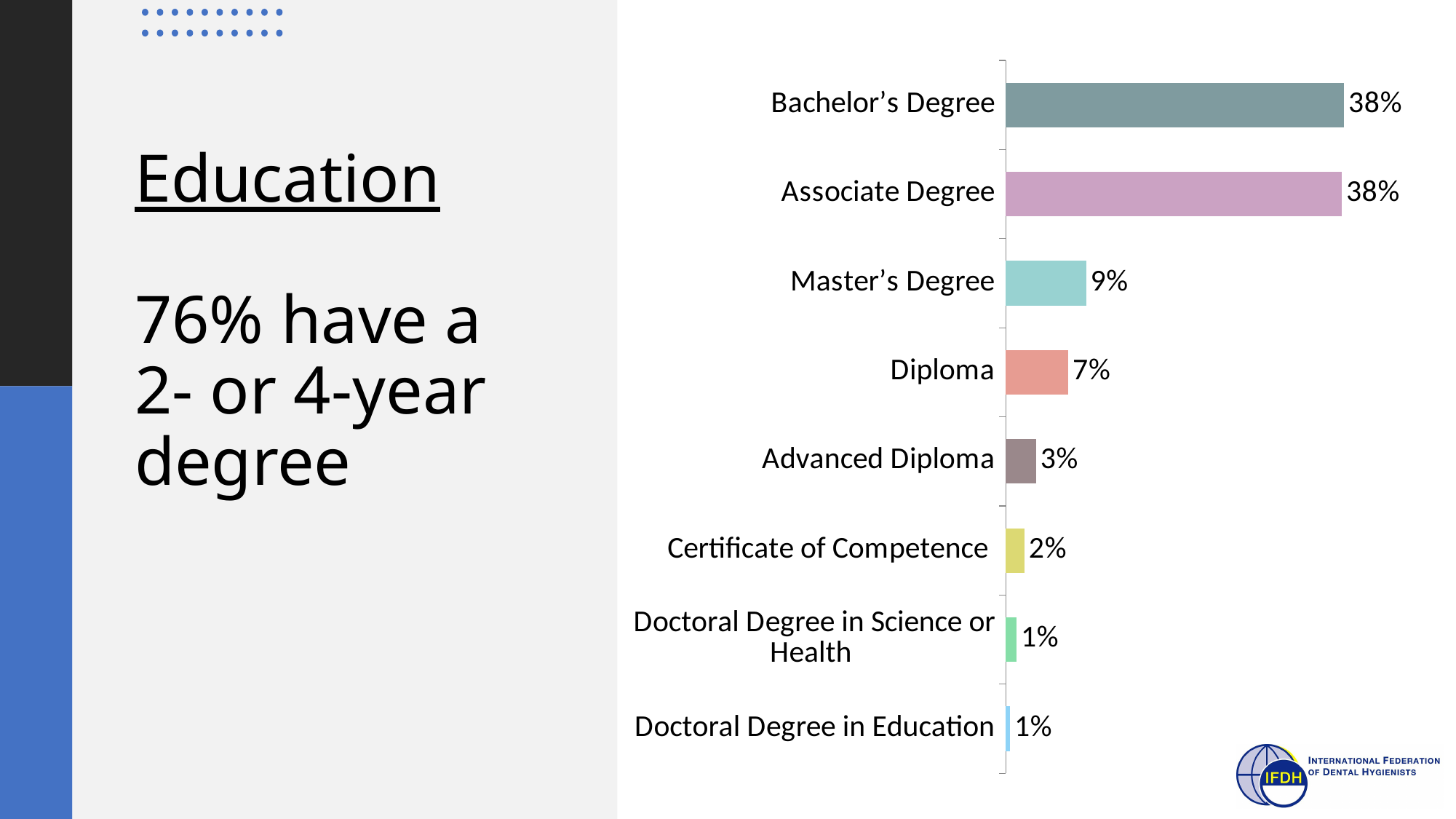
What is the difference between the values for Master's Degree and Diploma? 2% What kind of chart is shown on the slide? Bar chart What is the value for Bachelor's Degree? 38% How many categories are shown in the chart? 8 What is the title of the slide? Education What percentage is shown for Master's Degree? 9% What percentage is shown for Advanced Diploma? 3% What percentage is shown for Doctoral Degree in Education? 1% Which is larger, the value for Diploma or the value for Advanced Diploma? Diploma What is the difference between the values for Associate Degree and Master's Degree? 29% What is the value for Certificate of Competence? 2% What is the value for Diploma? 7%